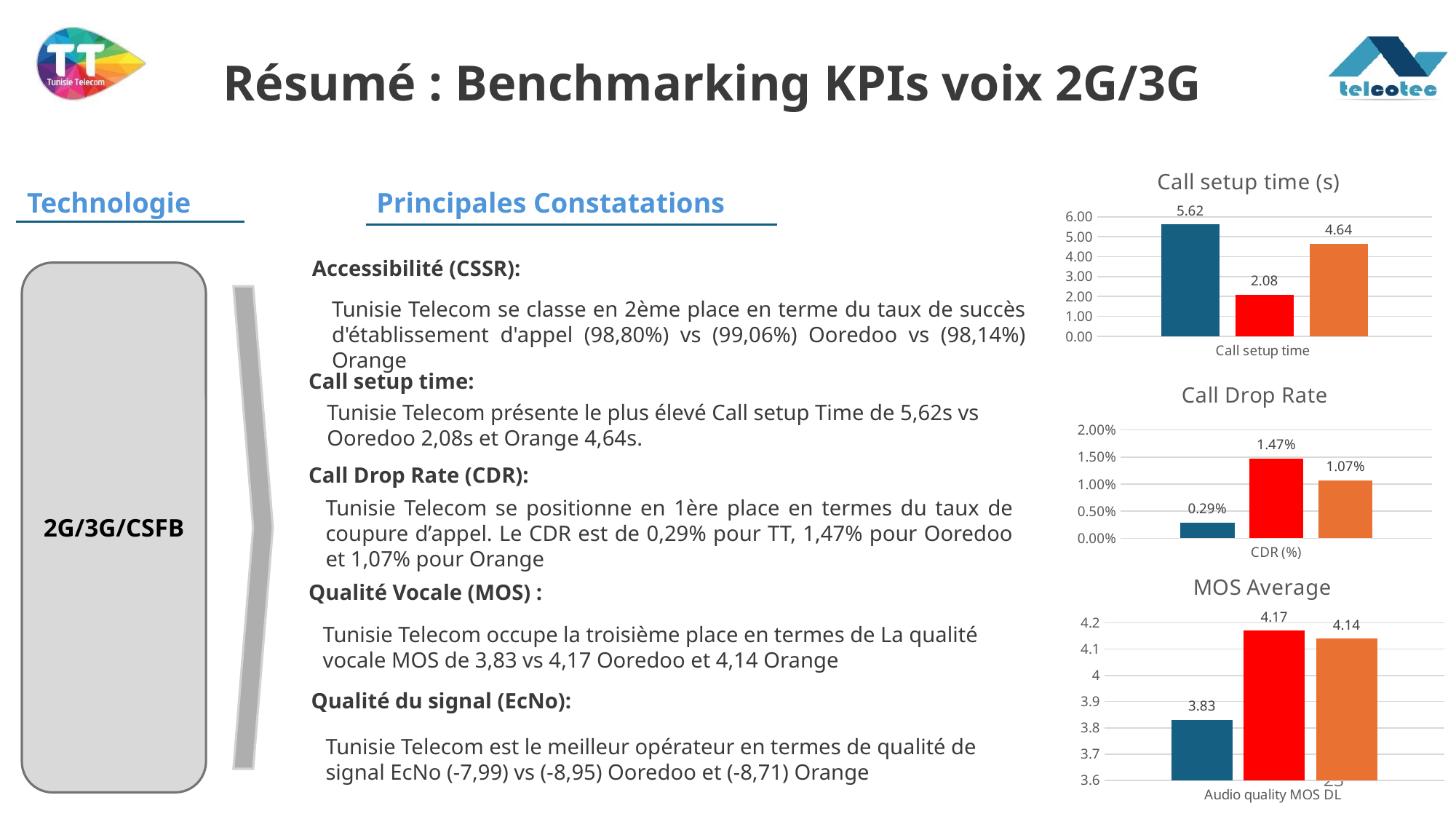
In the 'MOS Average' chart, what is the value shown on the orange (third) bar? 4.14 In the 'Call Drop Rate' chart, which bar has the lowest value? The blue (first) bar, 0.29% In the 'Call setup time (s)' chart, what is the difference between the blue bar (5.62) and the red bar (2.08)? 3.54 In the 'Call setup time (s)' chart, which bar is the tallest? The blue (first) bar, 5.62 What kind of chart is the 'Call Drop Rate' chart? Bar chart In the 'Call Drop Rate' chart, is the value of the orange bar greater or less than 1.00%? greater In the 'Call setup time (s)' chart, is the value of the orange bar greater or less than 4.00? greater In the 'MOS Average' chart, which is larger, the red bar or the orange bar? The red bar (4.17) In the 'Call setup time (s)' chart, what is the value shown on the blue (first) bar? 5.62 In the 'MOS Average' chart, what is the difference between the red bar (4.17) and the blue bar (3.83)? 0.34 How many bars are plotted in the 'Call setup time (s)' chart? 3 In the 'Call Drop Rate' chart, what is the value shown on the red (middle) bar? 1.47%